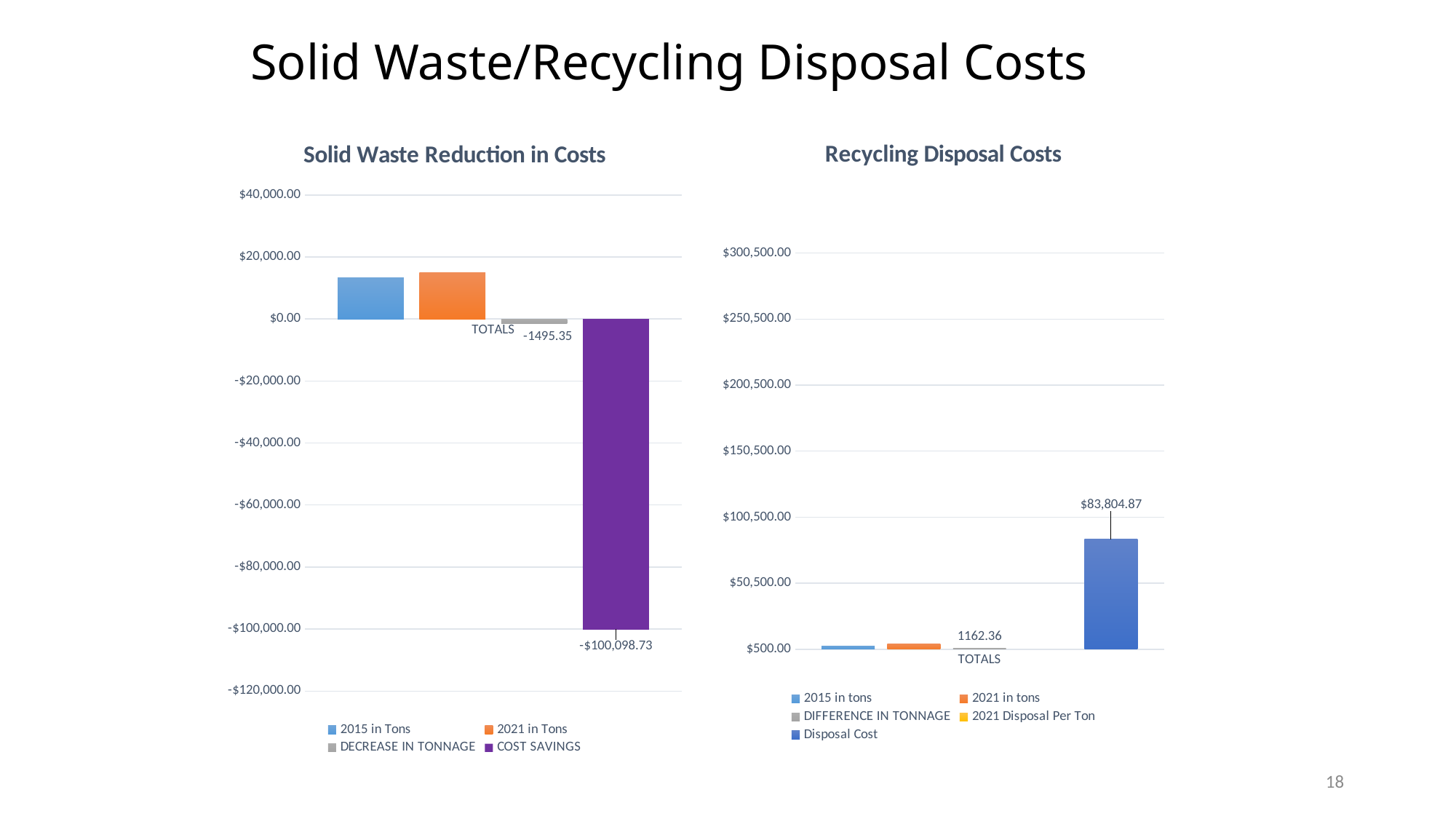
In the Solid Waste Reduction in Costs chart, what is the value shown for DECREASE IN TONNAGE? -1495.35 How many series does the legend of the Recycling Disposal Costs chart list? 5 In the Recycling Disposal Costs chart, which series has the highest value? Disposal Cost In the Recycling Disposal Costs chart, is the value for Disposal Cost greater or less than $100,500.00? less In the Recycling Disposal Costs chart, what is the value shown for Disposal Cost? $83,804.87 In the Solid Waste Reduction in Costs chart, is the value for 2015 in Tons greater or less than $20,000.00? less In the Solid Waste Reduction in Costs chart, which series has the lowest value? COST SAVINGS In the Solid Waste Reduction in Costs chart, which is larger, 2015 in Tons or 2021 in Tons? 2021 in Tons In the Solid Waste Reduction in Costs chart, what is the value shown for COST SAVINGS? -$100,098.73 What kind of chart is the Solid Waste Reduction in Costs chart? Bar chart How many series does the legend of the Solid Waste Reduction in Costs chart list? 4 In the Recycling Disposal Costs chart, what is the value shown for DIFFERENCE IN TONNAGE? 1162.36